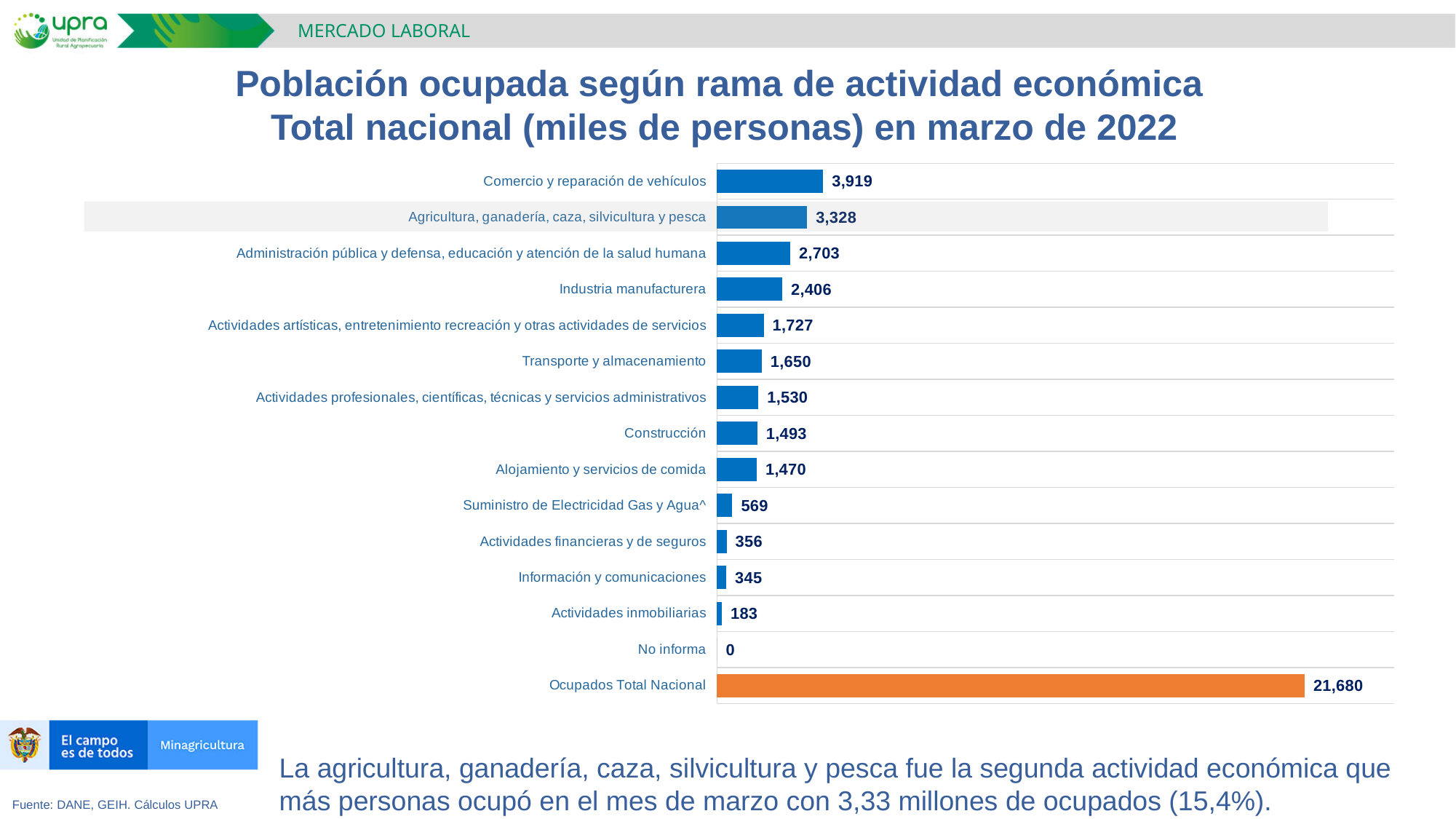
What is the difference between Actividades financieras y de seguros and Información y comunicaciones? 11 What is the difference between Comercio y reparación de vehículos and Agricultura, ganadería, caza, silvicultura y pesca? 591 How many categories are shown in the chart? 15 Which economic activity (excluding the national total) has the highest value? Comercio y reparación de vehículos What type of chart is shown on the slide? Bar chart What is the value for Agricultura, ganadería, caza, silvicultura y pesca? 3,328 Which category has the lowest value? No informa What is the value for Industria manufacturera? 2,406 Which bar is shown in orange rather than blue? Ocupados Total Nacional What is the value for Comercio y reparación de vehículos? 3,919 Which is larger, Transporte y almacenamiento or Construcción? Transporte y almacenamiento What is the value for Ocupados Total Nacional? 21,680